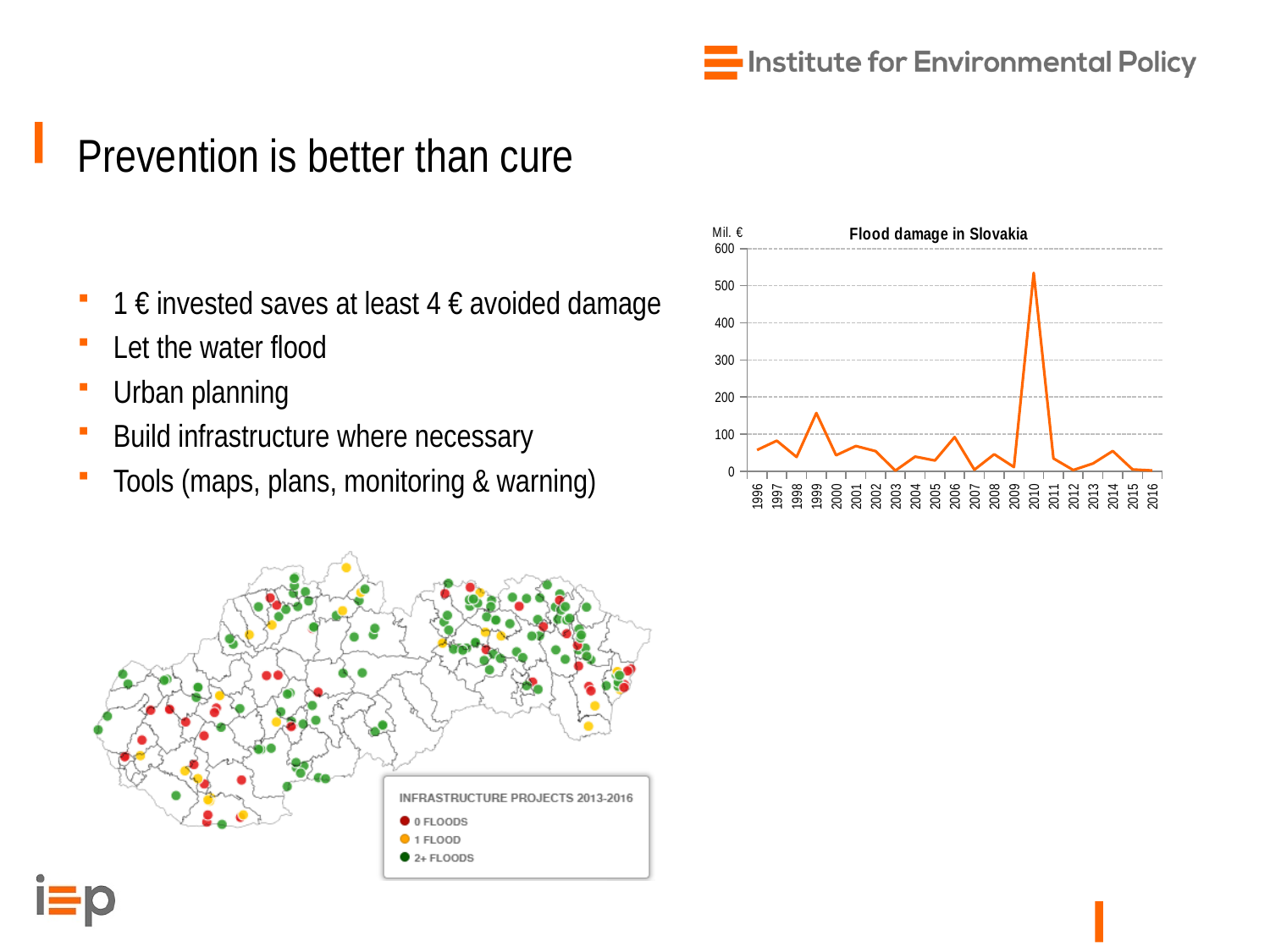
In the "Flood damage in Slovakia" chart, is the value for 2010 greater or less than 500? greater In the "Flood damage in Slovakia" chart, is the value for 1996 greater or less than 100? less In the "Flood damage in Slovakia" chart, which year has the larger value, 1999 or 2006? 1999 In the "Flood damage in Slovakia" chart, which year has the highest flood damage? 2010 In the "Flood damage in Slovakia" chart, which year has the larger value, 2010 or 1999? 2010 In the "Flood damage in Slovakia" chart, does the value rise or fall from 2010 to 2011? fall What type of chart is "Flood damage in Slovakia"? line chart In the "Flood damage in Slovakia" chart, is the value for 2006 greater or less than 200? less How many years are shown on the x axis of the "Flood damage in Slovakia" chart? 21 What unit is shown on the y axis of the "Flood damage in Slovakia" chart? Mil. €